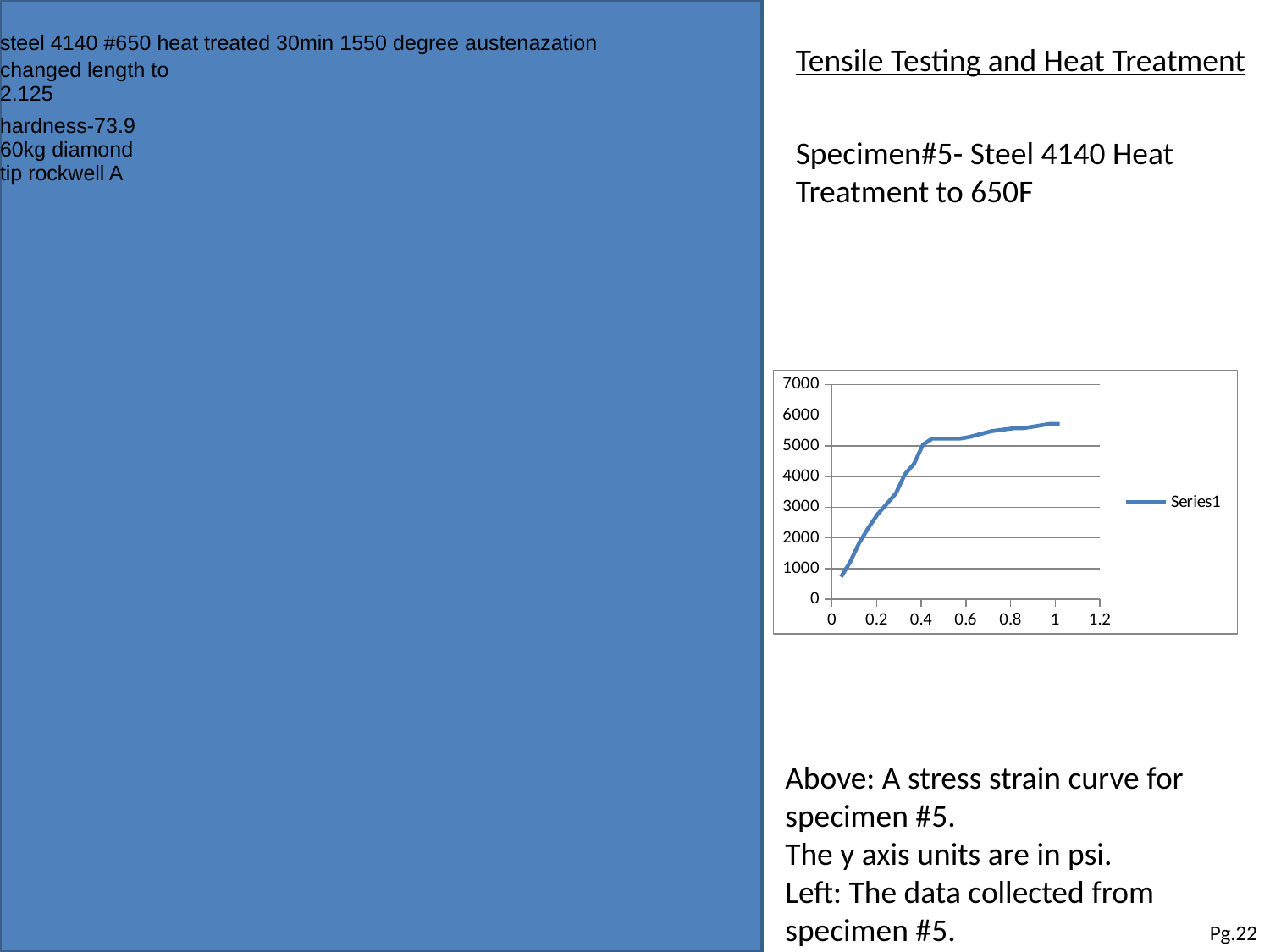
Do the values of Series1 rise or fall as the x axis increases from 0 to 1? rise Is the value of Series1 at x = 1 greater or less than 5000? greater How many series does the chart's legend list? 1 What is the name of the series shown in the chart's legend? Series1 Is the first plotted value of Series1 (near x = 0) greater or less than 1000? less Is the value of Series1 at x = 0.6 greater or less than 5000? greater What kind of chart is shown on the slide? line chart What is the highest tick value shown on the chart's y axis? 7000